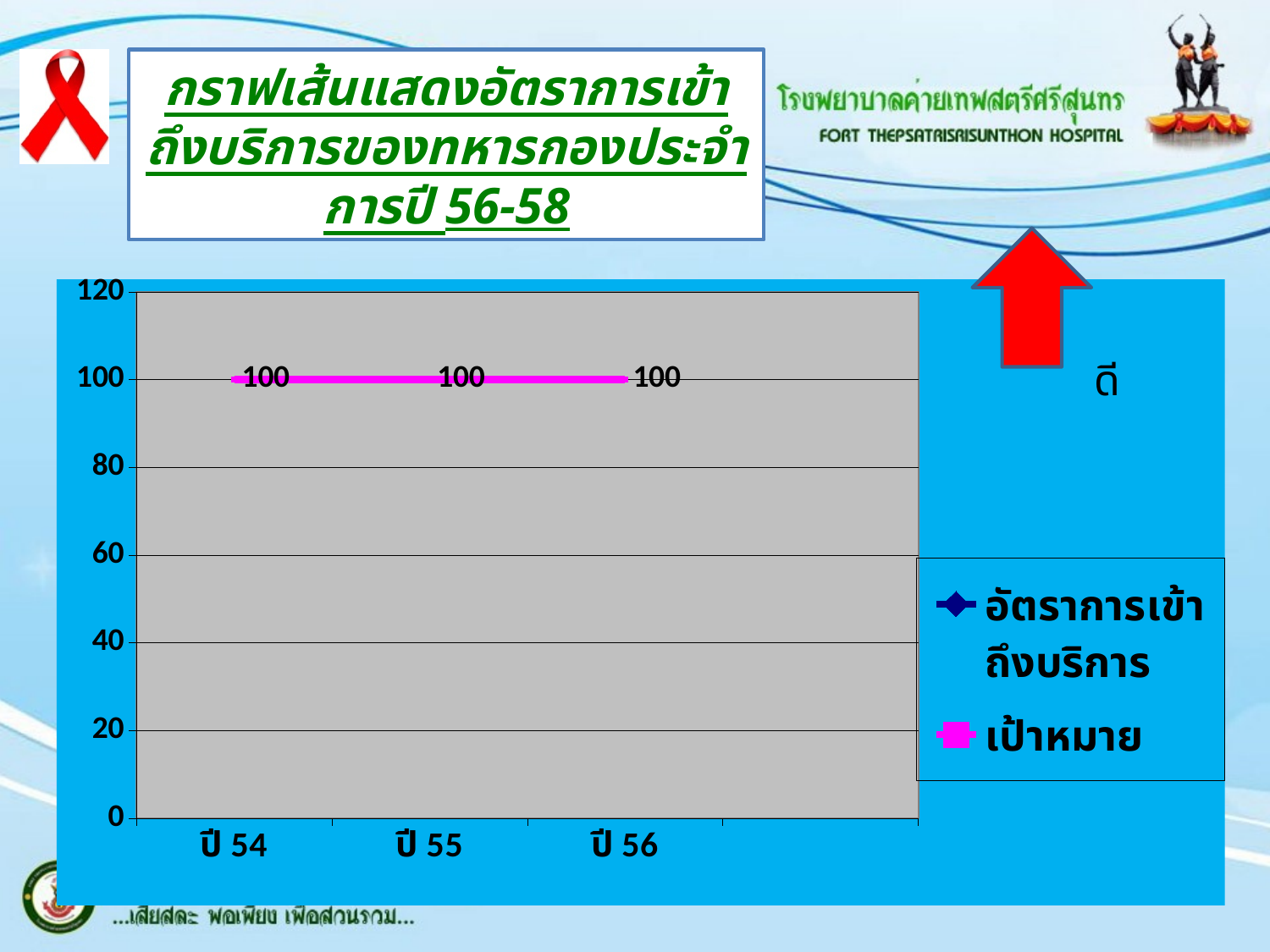
What is the value of เป้าหมาย for ปี 55? 100 Does the เป้าหมาย line rise, fall, or stay flat from ปี 54 to ปี 56? stays flat What is the value of เป้าหมาย for ปี 56? 100 Is the เป้าหมาย value for ปี 55 greater or less than 80? greater What is the value of เป้าหมาย for ปี 54? 100 What is the highest value shown on the y axis? 120 Which legend entry is shown with a pink square marker? เป้าหมาย How many series does the legend list? 2 How many categories are shown on the x axis? 3 What is the difference between the เป้าหมาย value for ปี 56 and for ปี 54? 0 What kind of chart is shown on the slide? line chart